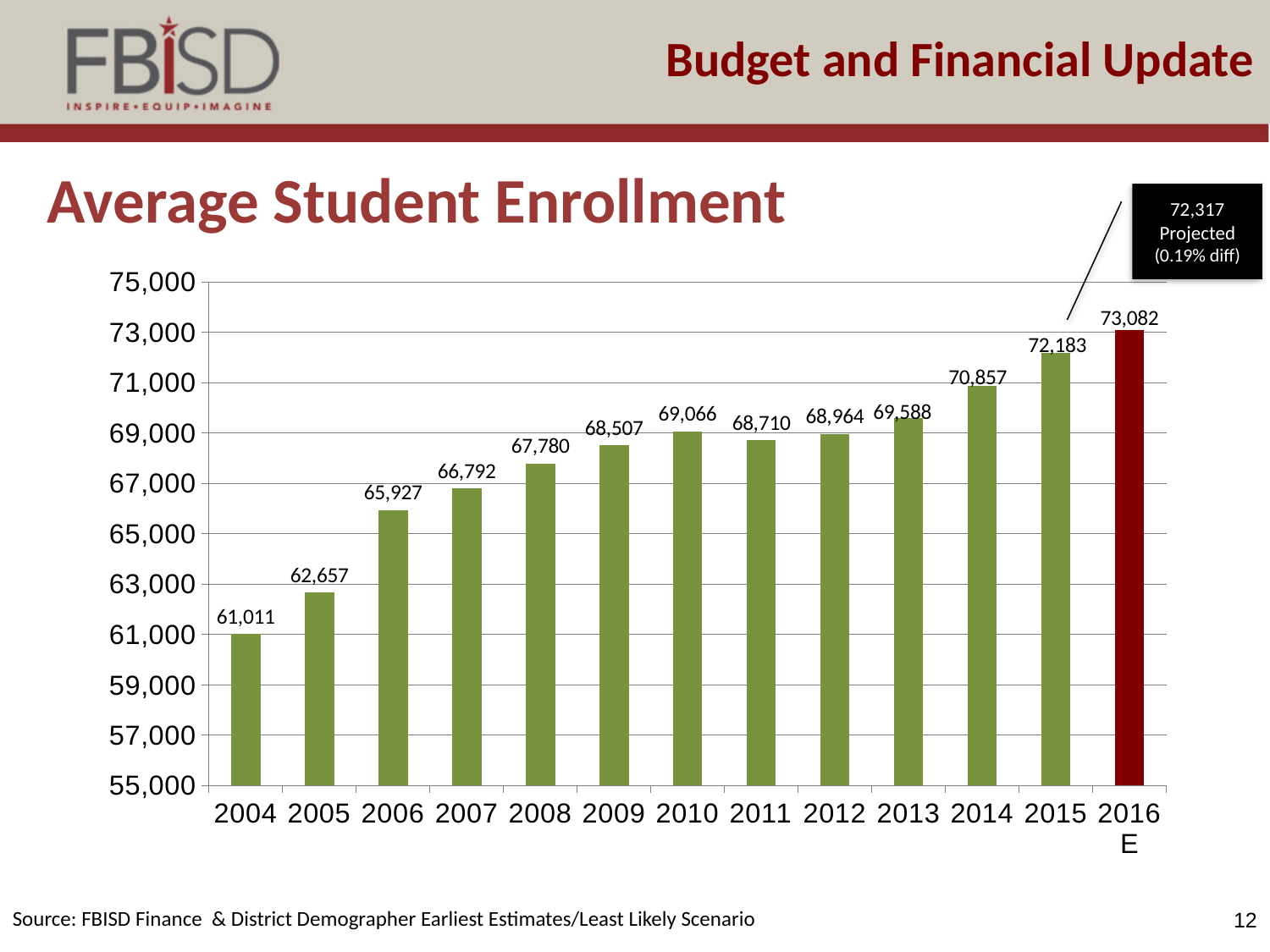
What is the average student enrollment for 2004? 61,011 Which year has higher average student enrollment, 2010 or 2011? 2010 What kind of chart is used to show average student enrollment? bar chart Does average student enrollment generally rise or fall from 2004 to 2016 E? rise Is the average student enrollment for 2008 greater or less than 67,000? greater What projected enrollment value is shown in the callout box for 2016 E? 72,317 Which year has the lowest average student enrollment? 2004 What is the average student enrollment for 2011? 68,710 Which year has the highest average student enrollment? 2016 E How many years are shown on the x axis of the chart? 13 What is the average student enrollment shown for 2016 E? 73,082 What is the difference in average student enrollment between 2015 and 2014? 1,326